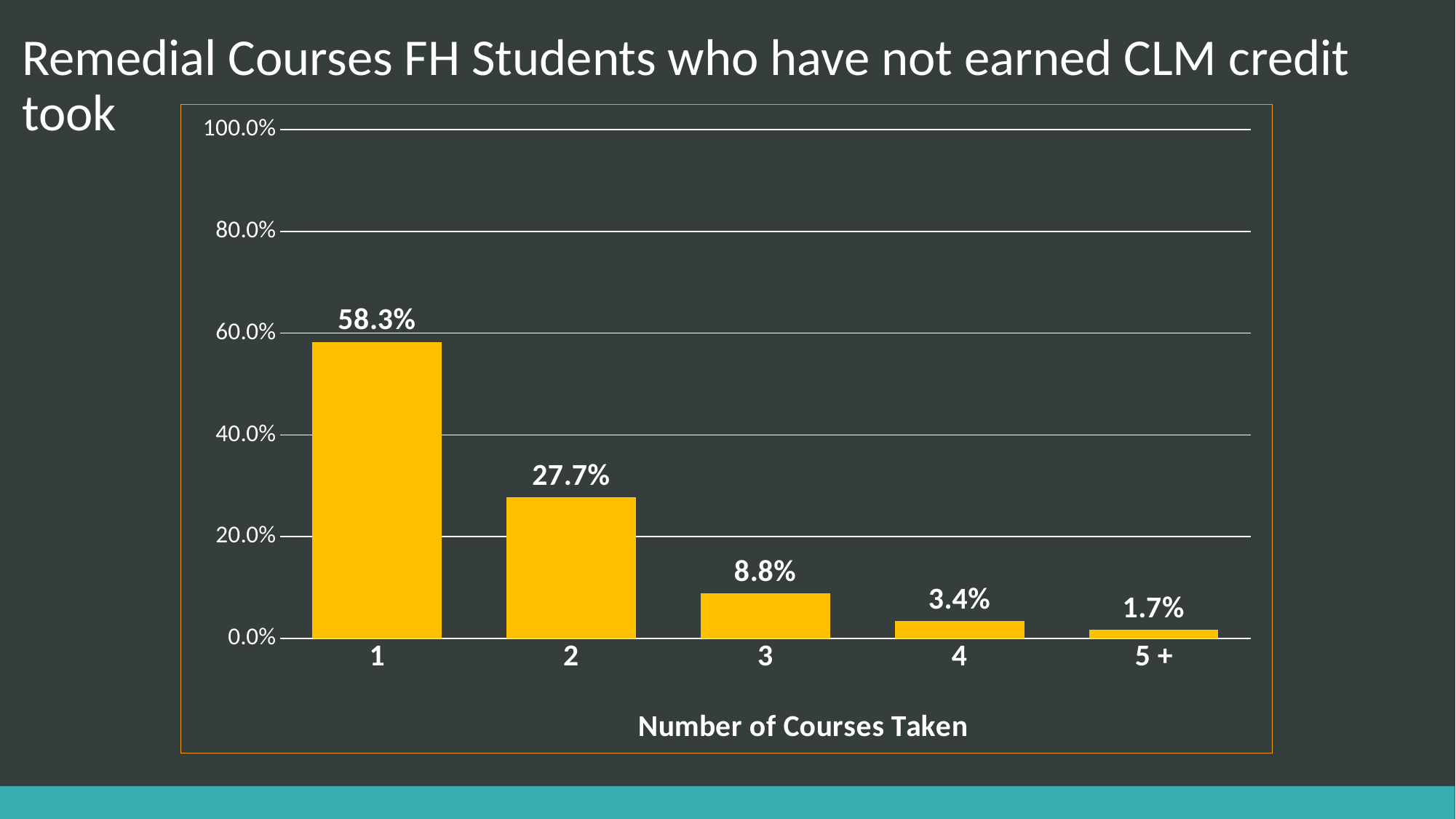
What percentage of students took 1 remedial course? 58.3% Which number of courses taken has the highest percentage? 1 What kind of chart is shown on the slide? Bar chart Which number of courses taken has the lowest percentage? 5 + Is the value for 2 courses greater or less than 20.0%? greater What is the difference between the percentages for 1 course and 2 courses? 30.6% How many categories are shown on the x axis? 5 What is the value shown for the '5 +' category? 1.7% What is the difference between the percentages for 3 courses and 4 courses? 5.4% Which is larger, the value for 3 courses or the value for 4 courses? 3 courses What percentage of students took 2 remedial courses? 27.7% Do the values rise or fall as the number of courses taken increases? Fall